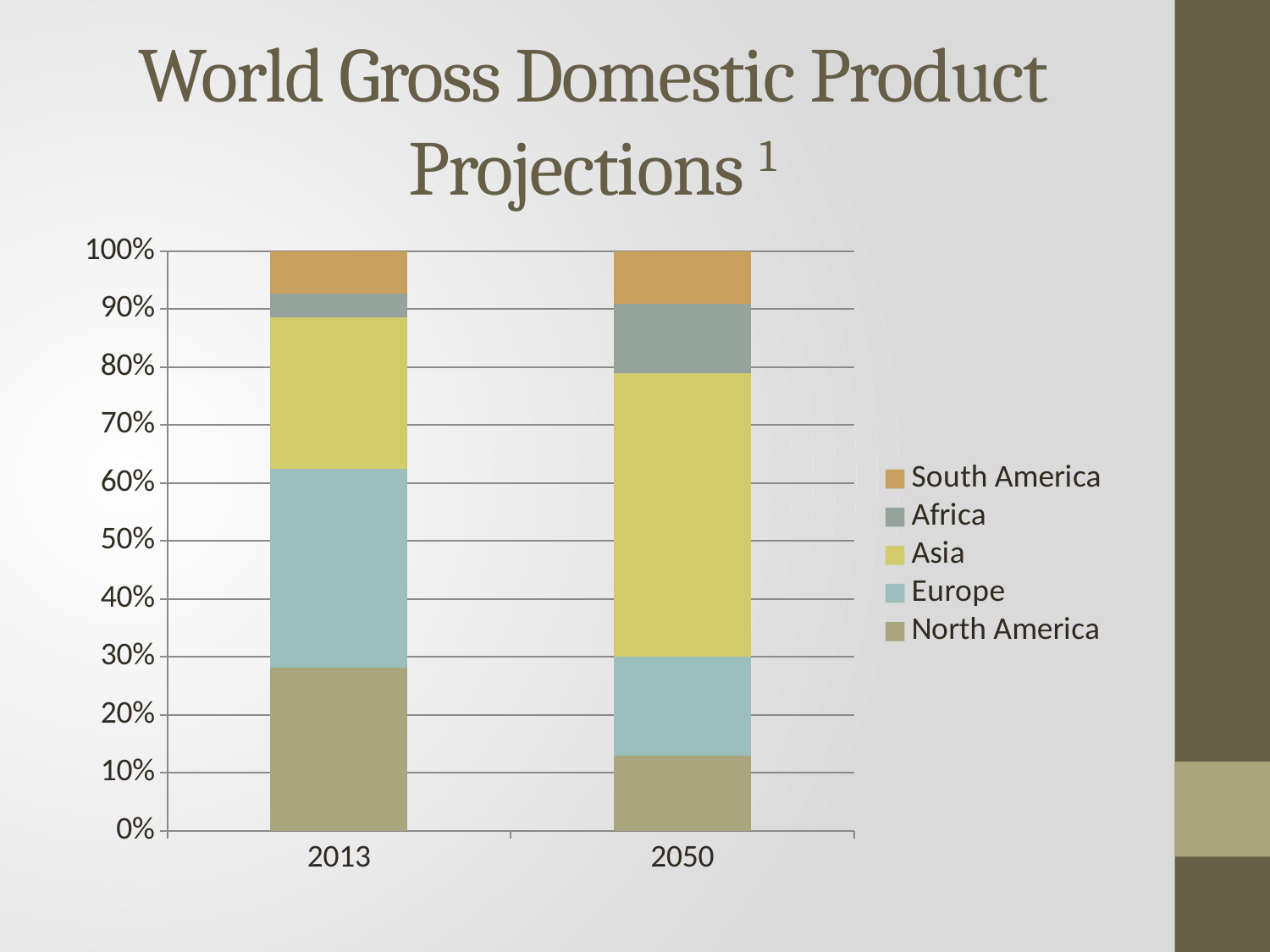
Does North America's share of world GDP rise or fall from 2013 to 2050? Fall Is the North America segment in the 2013 bar greater or less than 20%? greater How many years (categories) are plotted on the x axis? 2 Is the Asia segment in the 2050 bar greater or less than 40%? greater Which region has the largest share of world GDP in the 2013 bar? Europe How many series does the legend list? 5 Is Europe's share of world GDP larger in 2013 or in 2050? 2013 Which region has the largest share of world GDP in the 2050 bar? Asia What kind of chart is shown on the slide? Stacked bar chart Which region has the smallest share of world GDP in the 2013 bar? Africa What is the total height of each stacked bar on the percentage axis? 100% Is Asia's share of world GDP larger in 2013 or in 2050? 2050